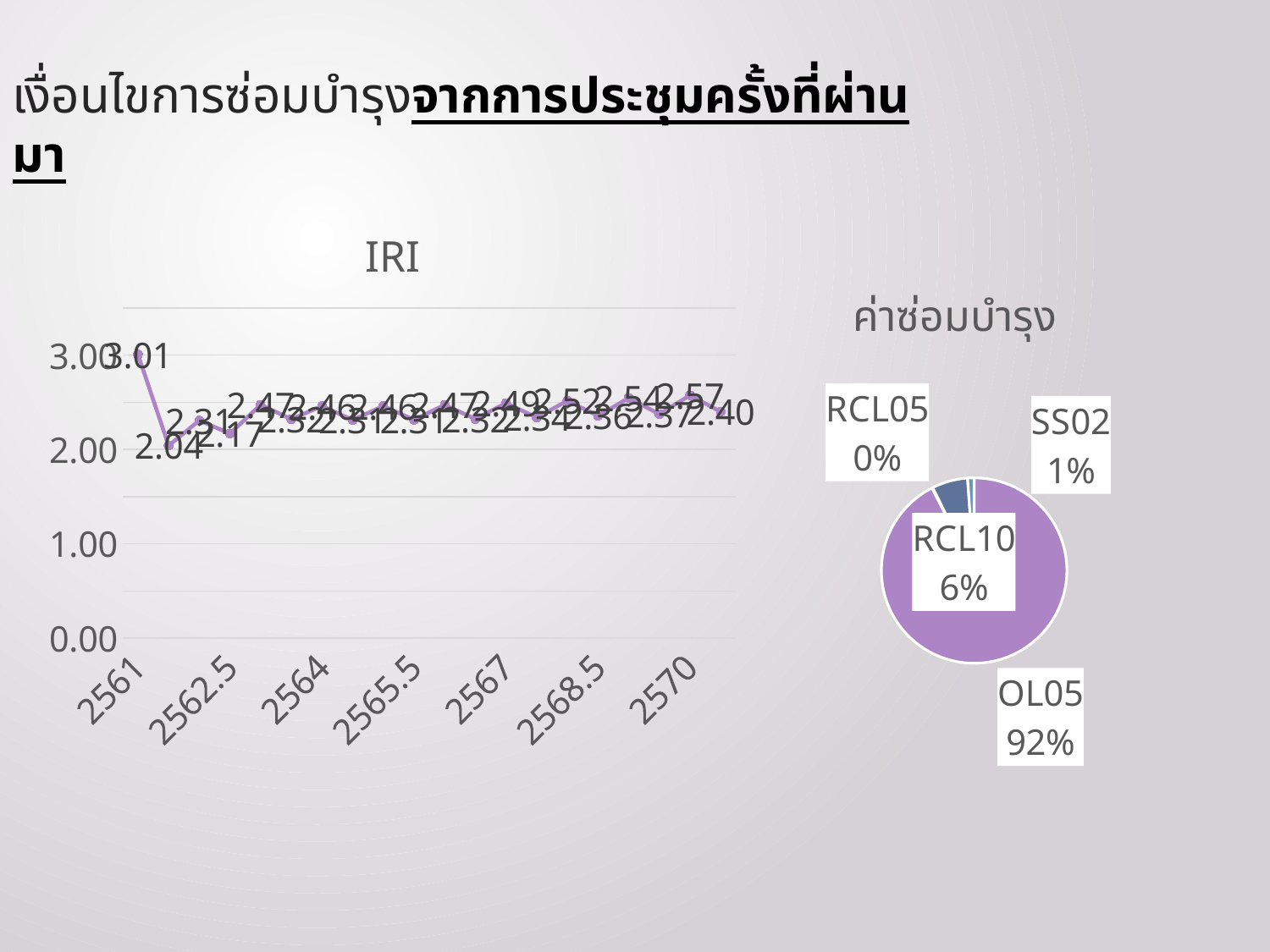
In the "ค่าซ่อมบำรุง" pie chart, which category has the largest slice? OL05 In the "ค่าซ่อมบำรุง" pie chart, what share does SS02 have? 1% How many categories are shown in the "ค่าซ่อมบำรุง" pie chart? 4 In the "IRI" line chart, what is the highest value plotted? 3.01 In the "ค่าซ่อมบำรุง" pie chart, which is larger, OL05 or RCL10? OL05 In the "IRI" line chart, what is the value of the last point on the right? 2.40 In the "ค่าซ่อมบำรุง" pie chart, what share does OL05 have? 92% In the "ค่าซ่อมบำรุง" pie chart, what share does RCL10 have? 6% What kind of chart is the chart titled "IRI"? line chart In the "IRI" line chart, what is the lowest value plotted? 2.04 In the "ค่าซ่อมบำรุง" pie chart, which category has the smallest share? RCL05 What kind of chart is the chart titled "ค่าซ่อมบำรุง"? pie chart